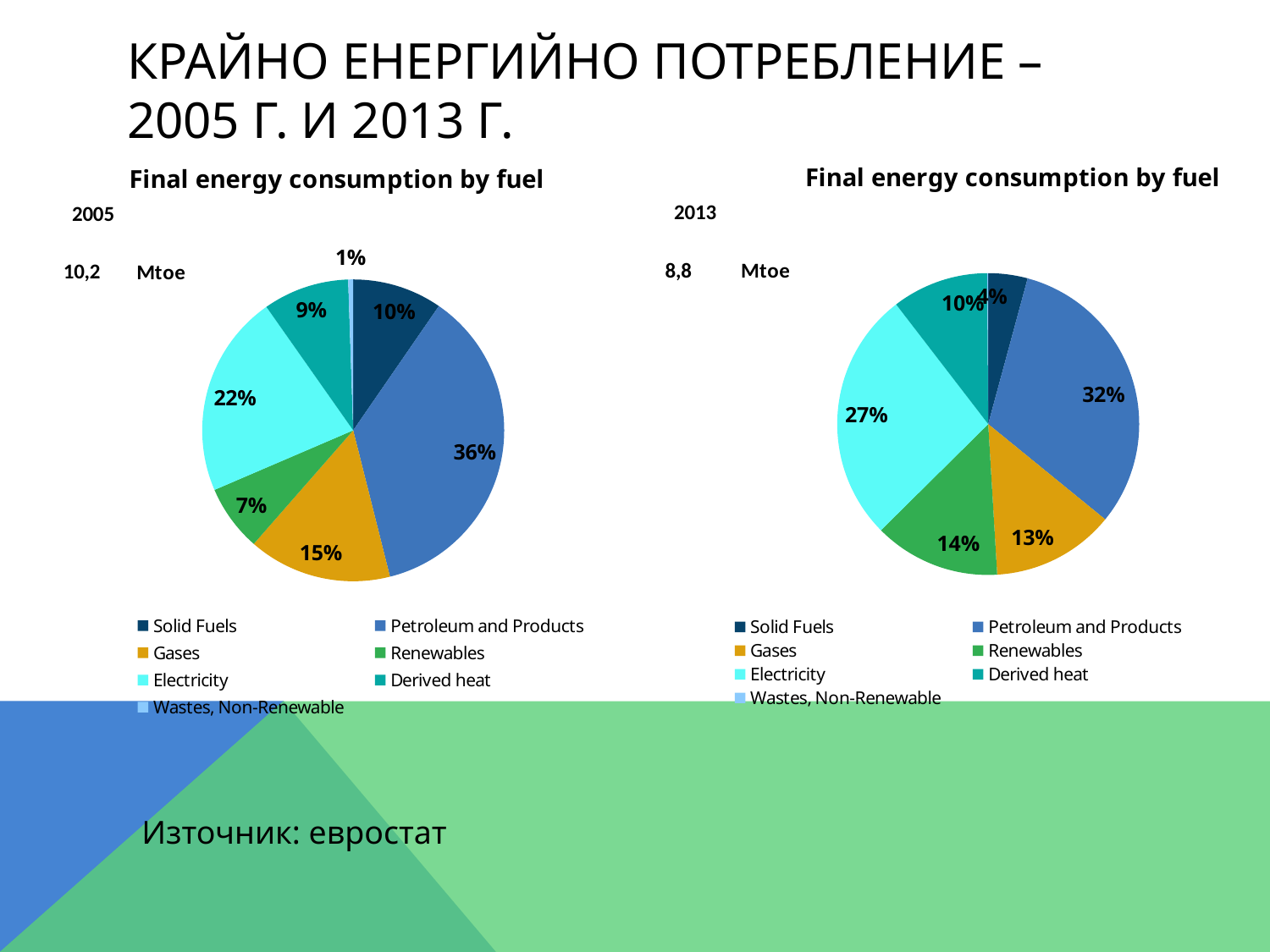
In the 2013 pie chart (right), what share does Petroleum and Products have? 32% In the 2005 pie chart (left), what is the difference between the Gases share and the Derived heat share? 6% In the 2005 pie chart (left), which fuel has the largest share? Petroleum and Products In the 2005 pie chart (left), which fuel has the smallest share? Wastes, Non-Renewable In the 2013 pie chart (right), what share does Electricity have? 27% In the 2013 pie chart (right), which is larger, the share for Gases or the share for Renewables? Renewables In the 2005 pie chart (left), what share does Renewables have? 7% In the 2013 pie chart (right), what share does Renewables have? 14% In the 2005 pie chart (left), what share does Petroleum and Products have? 36% How many entries does the legend of the 2013 pie chart (right) list? 7 What type of chart is used for the 2005 data on the left? Pie chart In the 2005 pie chart (left), what share does Electricity have? 22%